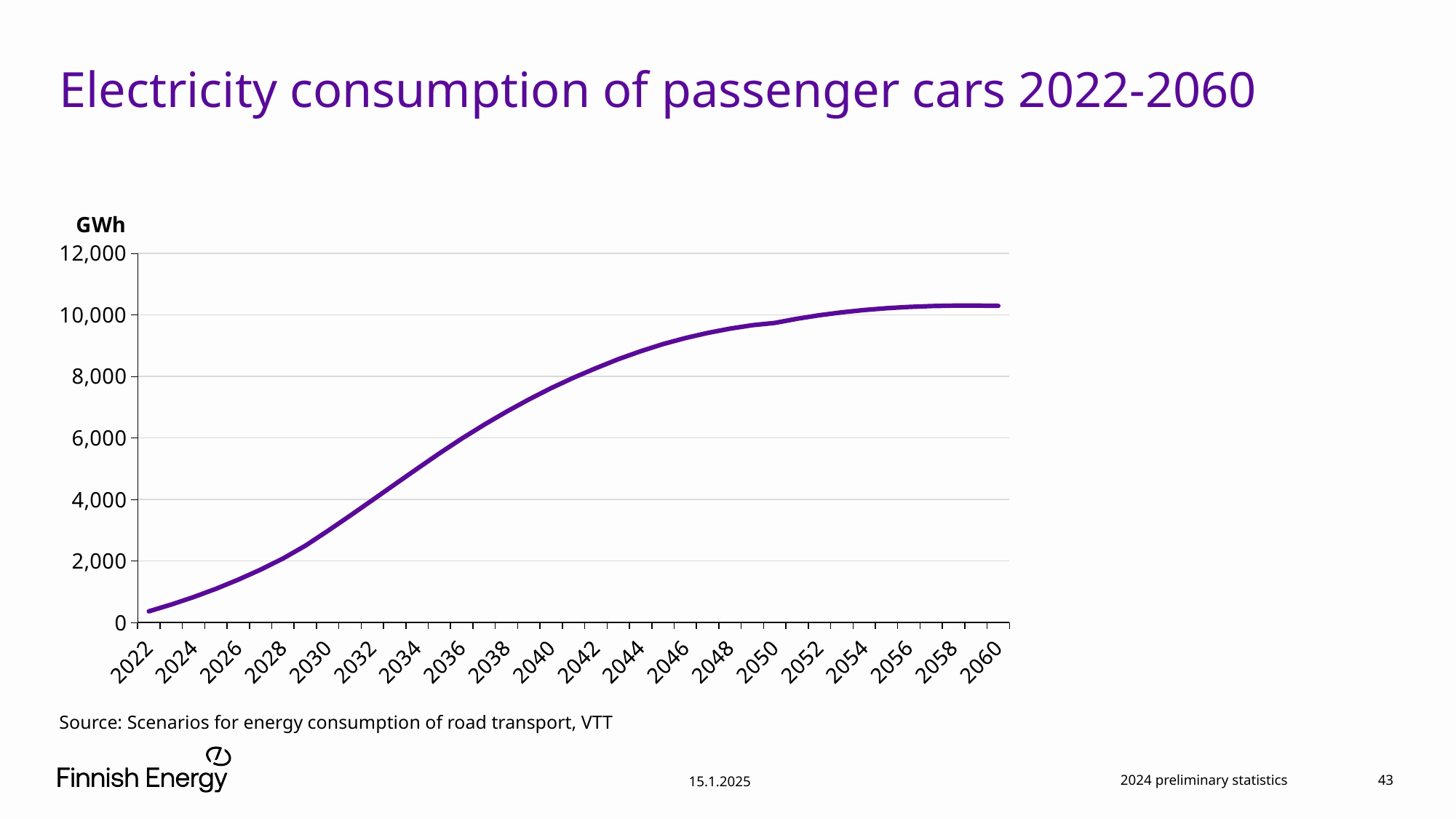
What kind of chart is shown on the slide? line chart Is the value for 2060 greater or less than 10,000 GWh? greater What is the title of the chart? Electricity consumption of passenger cars 2022-2060 What unit is shown on the vertical axis of the chart? GWh Is the value for 2044 greater or less than 8,000 GWh? greater Is the value for 2040 greater or less than 6,000 GWh? greater Which year has the lowest electricity consumption on the chart? 2022 Does the electricity consumption of passenger cars rise or fall from 2022 to 2060? rise How many year labels are shown on the x axis of the chart? 20